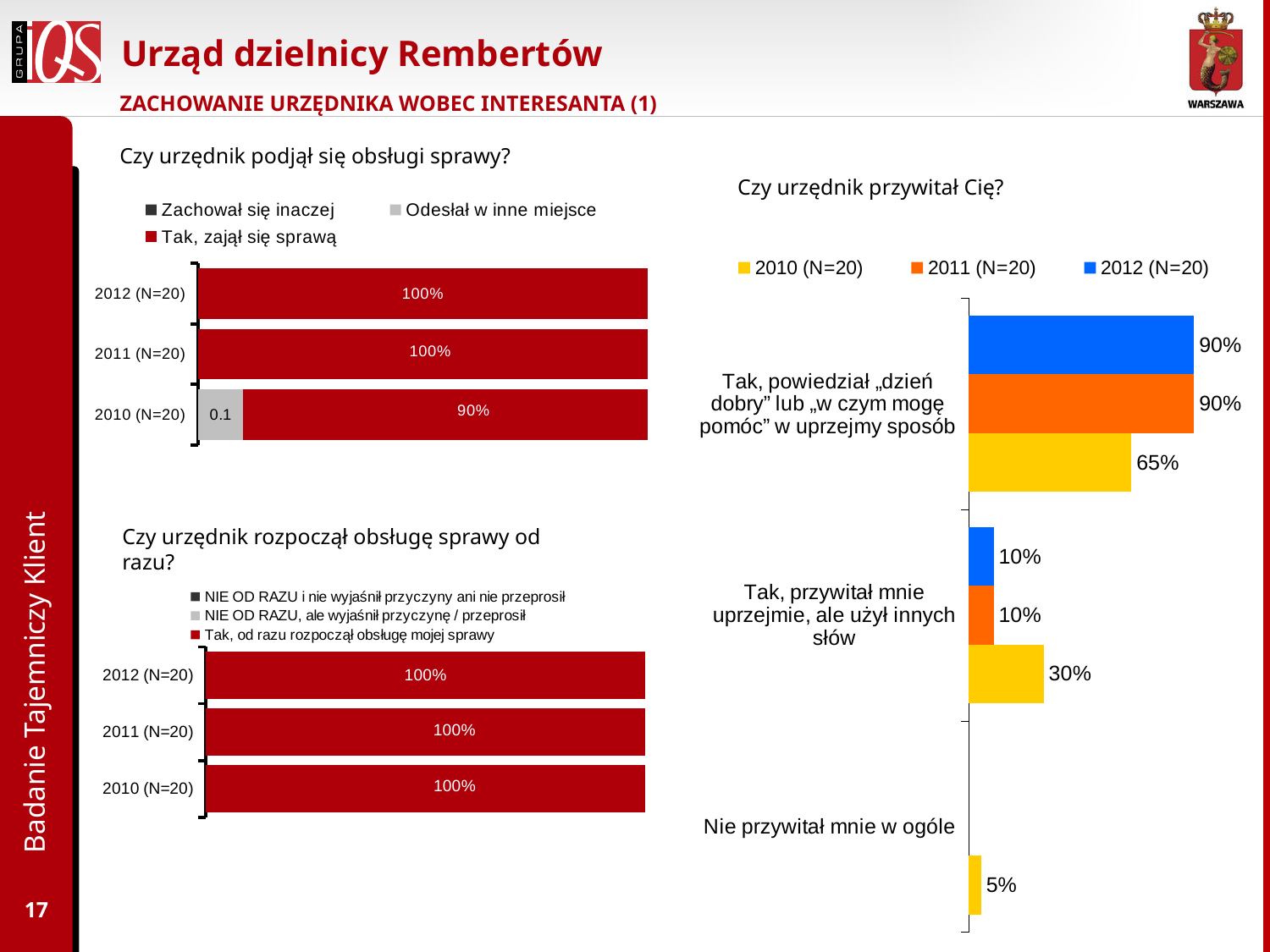
In the chart "Czy urzędnik przywitał Cię?", which year has the highest value in the category "Tak, przywitał mnie uprzejmie, ale użył innych słów"? 2010 (N=20) In the chart "Czy urzędnik przywitał Cię?", what is the value for 2012 (N=20) in the category "Tak, przywitał mnie uprzejmie, ale użył innych słów"? 10% In the chart "Czy urzędnik przywitał Cię?", how many categories are shown on the axis? 3 In the chart "Czy urzędnik przywitał Cię?", what is the value for 2010 (N=20) in the category "Tak, powiedział „dzień dobry” lub „w czym mogę pomóc” w uprzejmy sposób"? 65% In the chart "Czy urzędnik przywitał Cię?", what is the value for 2010 (N=20) in the category "Nie przywitał mnie w ogóle"? 5% What type of chart is "Czy urzędnik przywitał Cię?"? Bar chart In the chart "Czy urzędnik podjął się obsługi sprawy?", what is the value of "Tak, zajął się sprawą" for 2010 (N=20)? 90% In the chart "Czy urzędnik przywitał Cię?", how many series does the legend list? 3 In the chart "Czy urzędnik podjął się obsługi sprawy?", what is the value of "Tak, zajął się sprawą" for 2012 (N=20)? 100% In the chart "Czy urzędnik rozpoczął obsługę sprawy od razu?", what is the value of "Tak, od razu rozpoczął obsługę mojej sprawy" for 2011 (N=20)? 100% In the chart "Czy urzędnik przywitał Cię?", what is the difference between the 2012 (N=20) and 2010 (N=20) values in the category "Tak, powiedział „dzień dobry” lub „w czym mogę pomóc” w uprzejmy sposób"? 25% In the chart "Czy urzędnik podjął się obsługi sprawy?", which year has the lowest value of "Tak, zajął się sprawą"? 2010 (N=20)